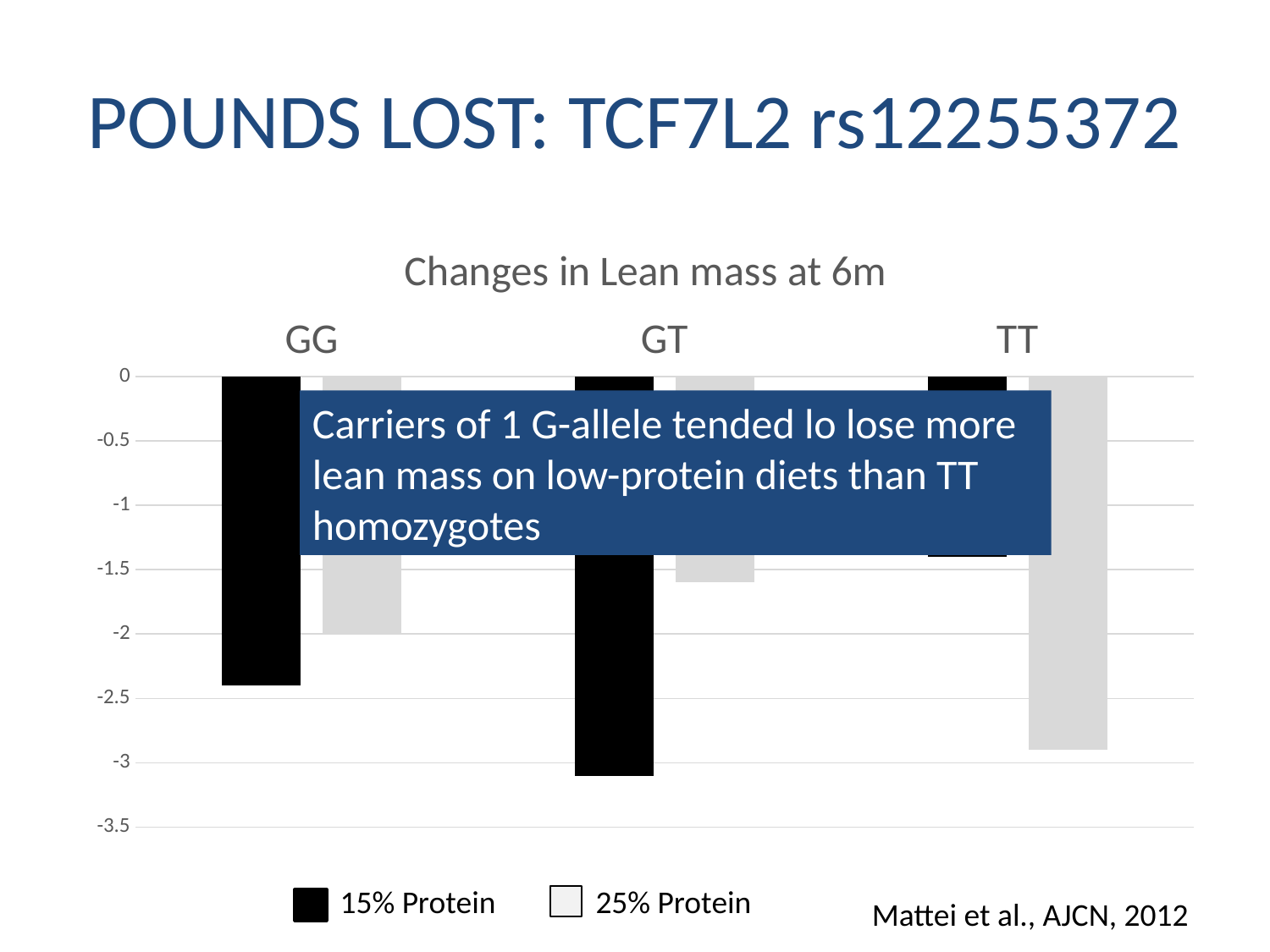
Which genotype has the lowest (most negative) value for 15% Protein? GT How many genotype categories are shown on the x axis? 3 What is the title of the chart? Changes in Lean mass at 6m Which genotype has the lowest (most negative) value for 25% Protein? TT Is the 25% Protein value for TT greater or less than -2.5? less What kind of chart is shown on the slide? bar chart Which colour represents the 15% Protein series? black Which genotype has the highest (least negative) value for 25% Protein? GT For TT, which series has the larger (less negative) value, 15% Protein or 25% Protein? 15% Protein Is the 15% Protein value for GT greater or less than -3? less How many series does the legend list? 2 Which genotype has the highest (least negative) value for 15% Protein? TT